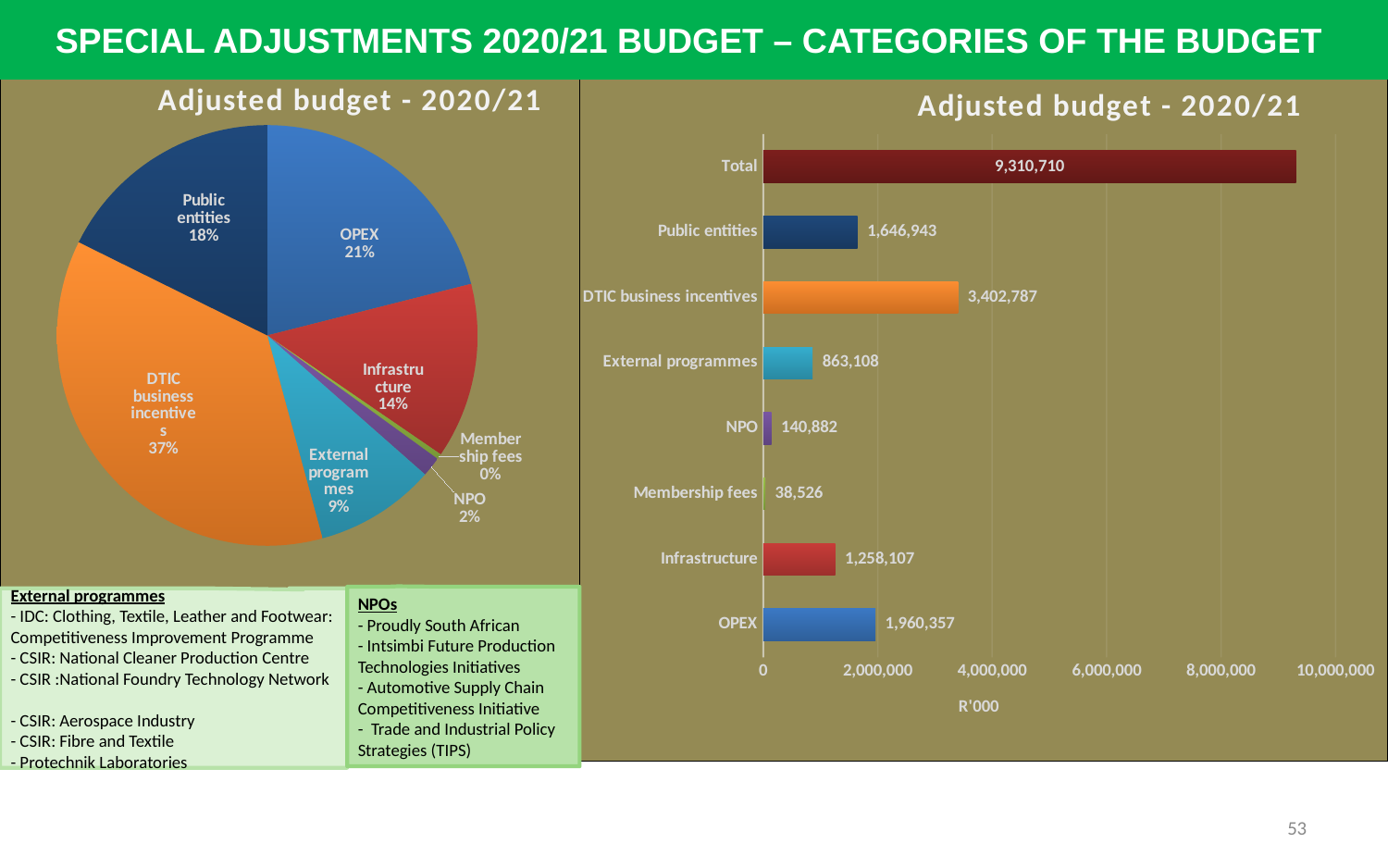
In the bar chart on the right, excluding the Total bar, which category has the lowest value? Membership fees How many categories, including Total, are shown in the bar chart on the right? 8 In the bar chart on the right, what is the value for Membership fees? 38,526 In the pie chart on the left, what share of the budget is Public entities? 18% In the bar chart on the right, what is the value of the Total bar? 9,310,710 What unit is shown on the horizontal axis of the bar chart on the right? R'000 In the bar chart on the right, what is the value for DTIC business incentives? 3,402,787 In the bar chart on the right, excluding the Total bar, which category has the highest value? DTIC business incentives What type of chart is on the left side of the slide? Pie chart In the pie chart on the left, what share of the budget is DTIC business incentives? 37% In the bar chart on the right, which is larger, Public entities or External programmes? Public entities In the bar chart on the right, what is the difference between OPEX and Infrastructure? 702,250